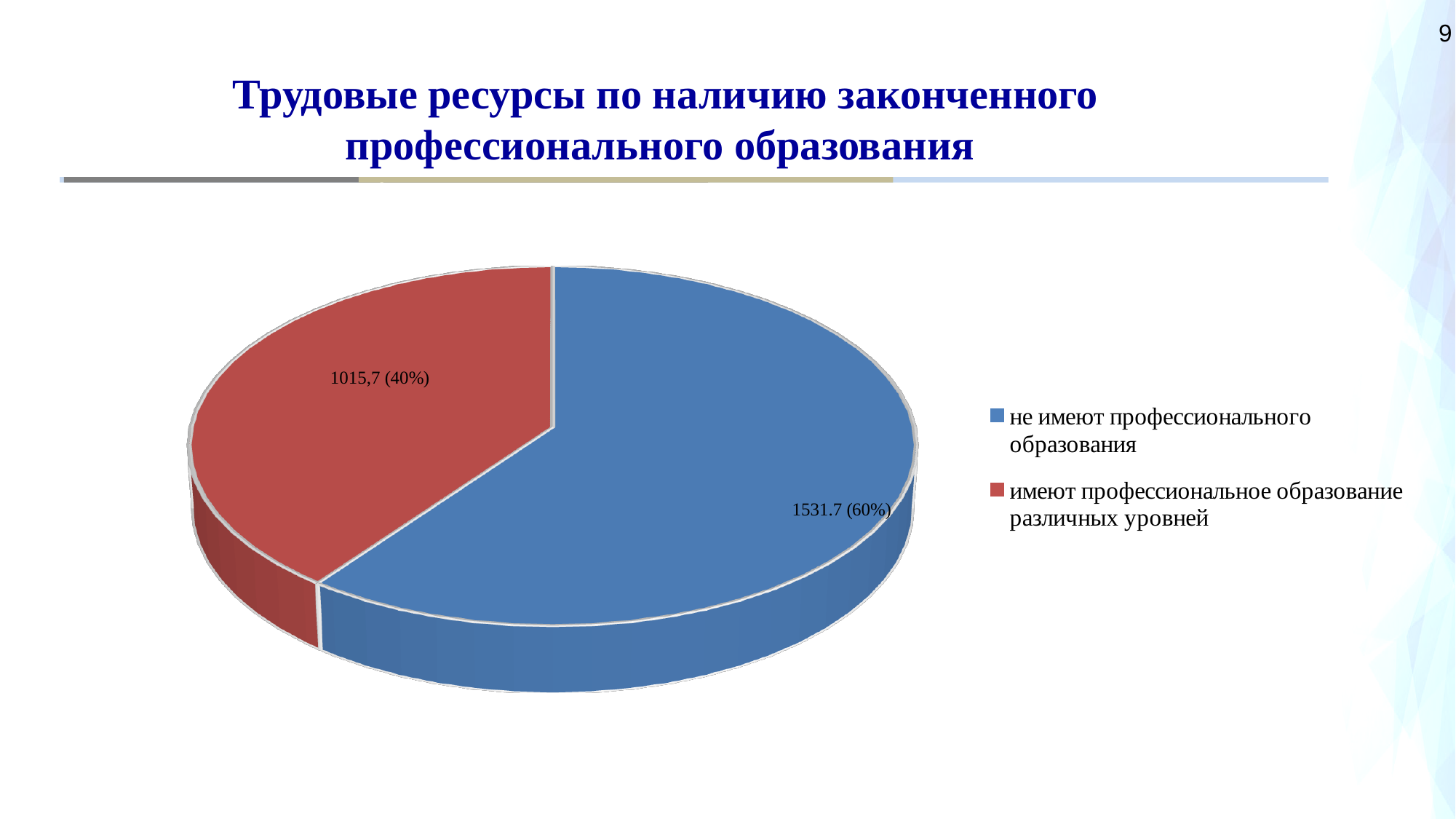
Which slice is the smallest in the pie chart? имеют профессиональное образование различных уровней How many entries does the legend list? 2 What share of the pie does the slice 'не имеют профессионального образования' represent? 60% What is the title of the chart on the slide? Трудовые ресурсы по наличию законченного профессионального образования What value is shown for the slice 'имеют профессиональное образование различных уровней'? 1015,7 What value is shown for the slice 'не имеют профессионального образования'? 1531.7 How many slices does the pie chart have? 2 What kind of chart is shown on the slide? Pie chart What is the difference between the value for 'не имеют профессионального образования' and the value for 'имеют профессиональное образование различных уровней'? 516 What share of the pie does the slice 'имеют профессиональное образование различных уровней' represent? 40% Which slice is the largest in the pie chart? не имеют профессионального образования Which is larger: the value for 'не имеют профессионального образования' or for 'имеют профессиональное образование различных уровней'? не имеют профессионального образования